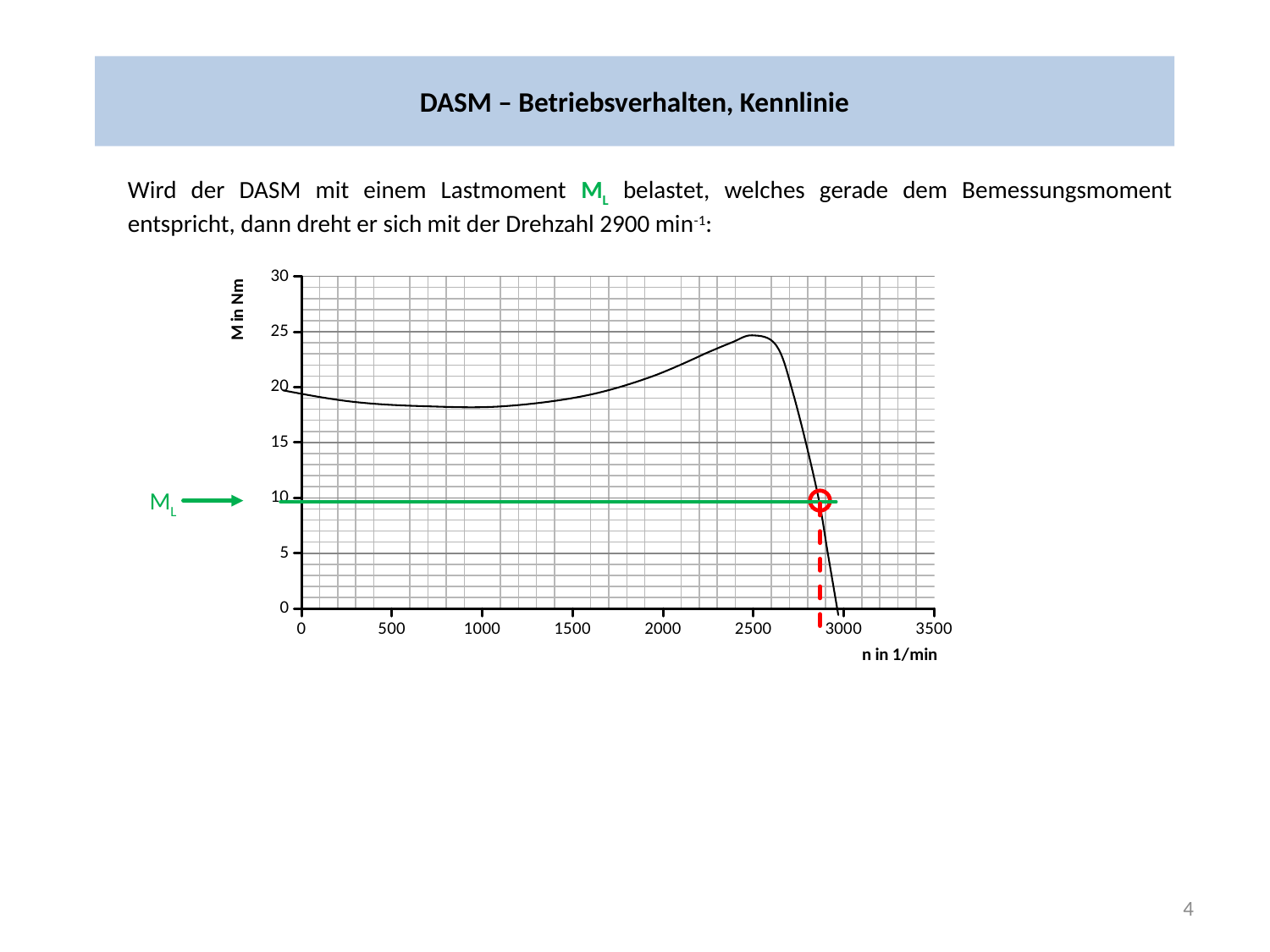
Is the load torque M_L (green line) greater or less than 15 Nm? less Is the torque M at n = 1000 1/min greater or less than 20 Nm? less Does the torque curve rise or fall between n = 2500 1/min and n = 3000 1/min? fall Does the torque curve rise or fall between n = 1000 1/min and n = 2500 1/min? rise What is the label of the x axis of the chart? n in 1/min At which speed does the motor run when loaded with the rated torque M_L, according to the slide? 2900 min^-1 Is the torque M at n = 2500 1/min greater or less than 20 Nm? greater Which is larger, the torque at n = 2500 1/min or the torque at n = 1000 1/min? n = 2500 1/min What kind of chart is shown on the slide? line chart What is the label of the y axis of the chart? M in Nm